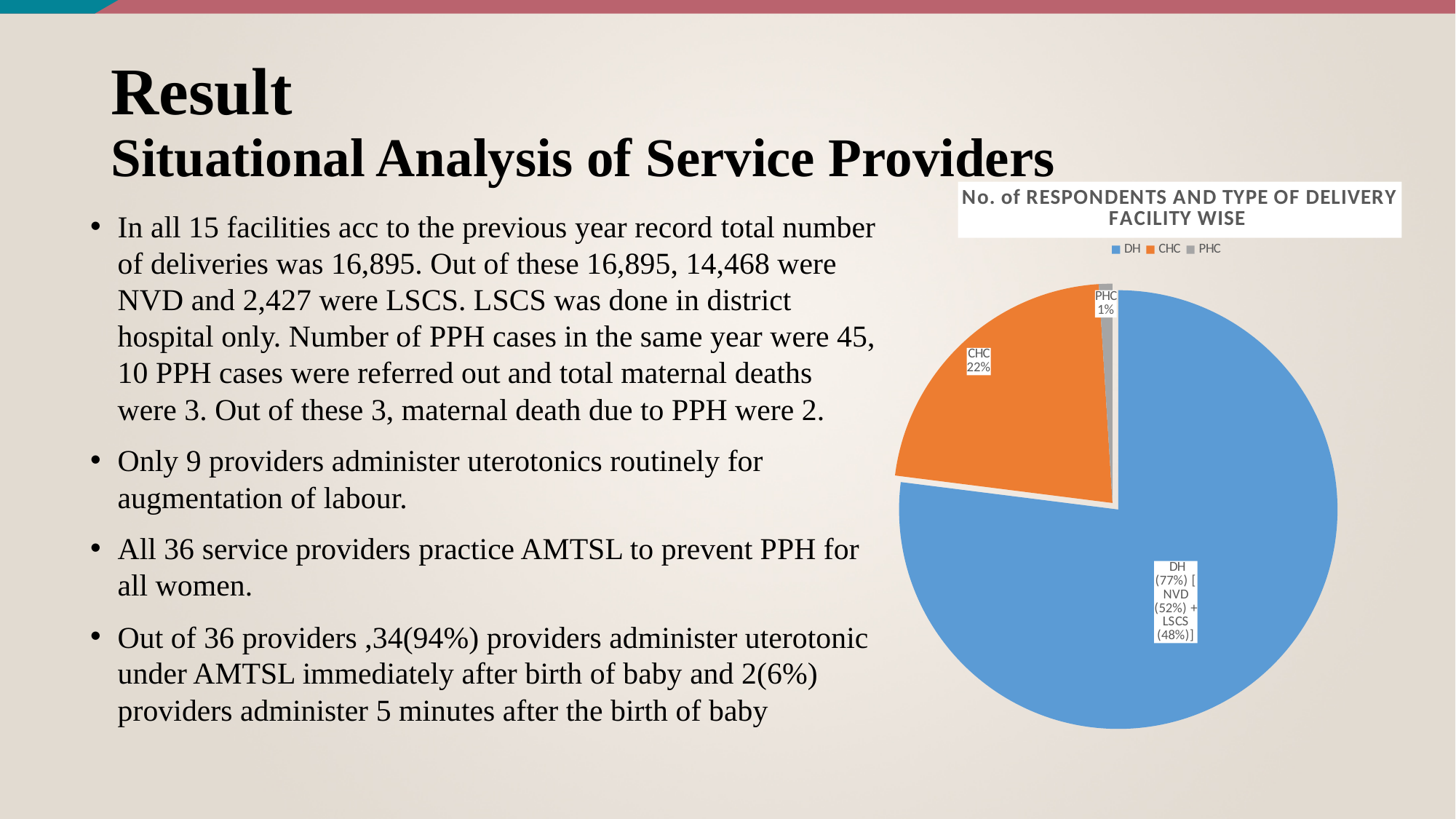
What is the difference in percentage points between the DH share and the CHC share? 55 What kind of chart is shown on the slide? pie chart What share of the pie does PHC represent? 1% Which colour represents CHC in the pie chart? orange What share of the pie does CHC represent? 22% Which slice is larger, CHC or PHC? CHC Which facility type has the smallest slice of the pie? PHC How many slices does the pie chart have? 3 What share of the pie does DH represent? 77% Which facility type has the largest slice of the pie? DH How many entries does the chart legend list? 3 What is the title of the chart? No. of RESPONDENTS AND TYPE OF DELIVERY FACILITY WISE